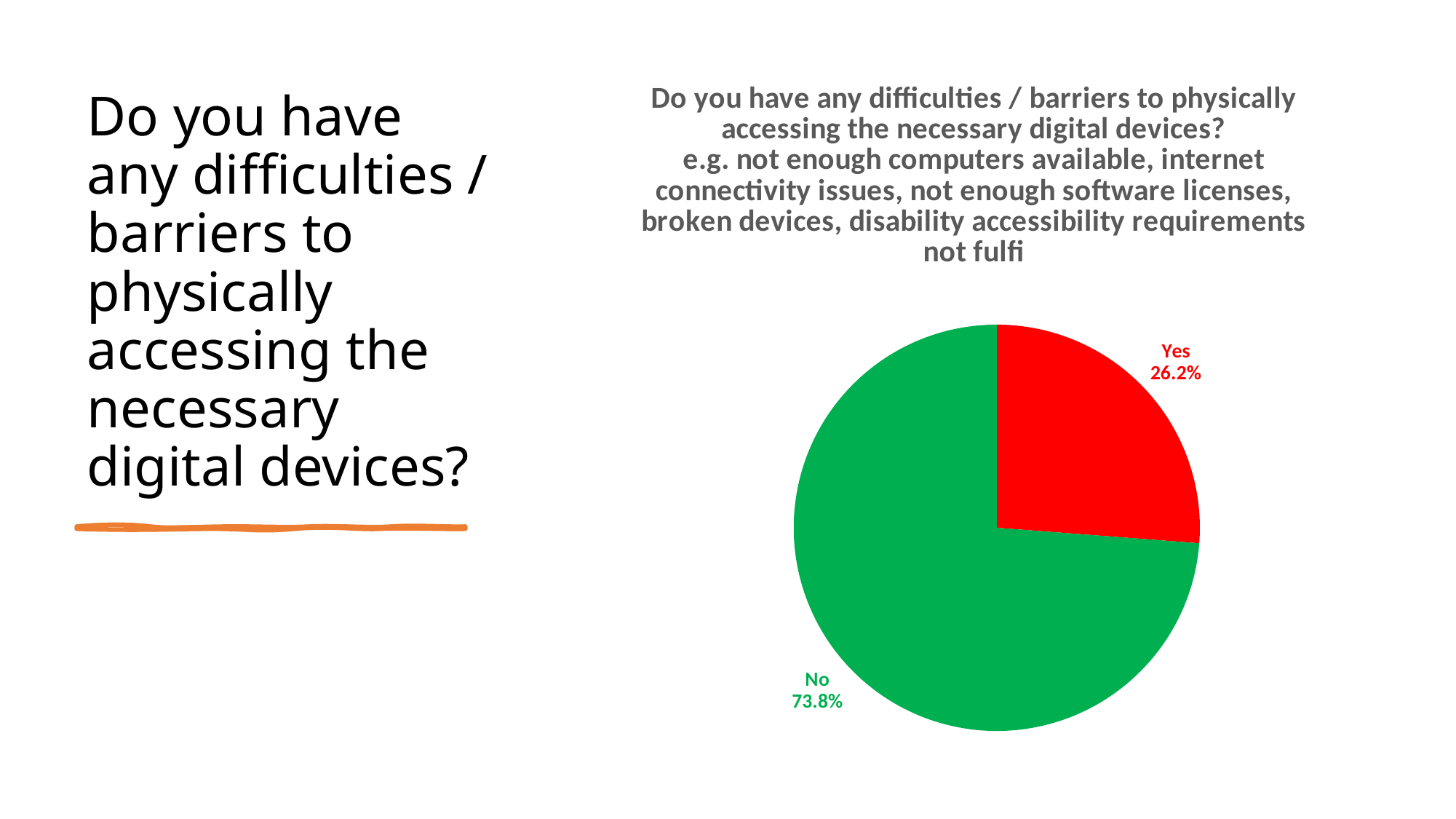
What kind of chart is shown on the slide? Pie chart What percentage of respondents answered "No"? 73.8% Which response has the smallest share of the pie? Yes Which response has the largest share of the pie? No What percentage of respondents answered "Yes"? 26.2% What share of the pie does the "No" slice represent? 73.8% Which slice is larger, "Yes" or "No"? No What is the difference in percentage points between the "No" and "Yes" slices? 47.6 How many slices does the pie chart have? 2 What colour is the "Yes" slice? Red What colour is the "No" slice? Green